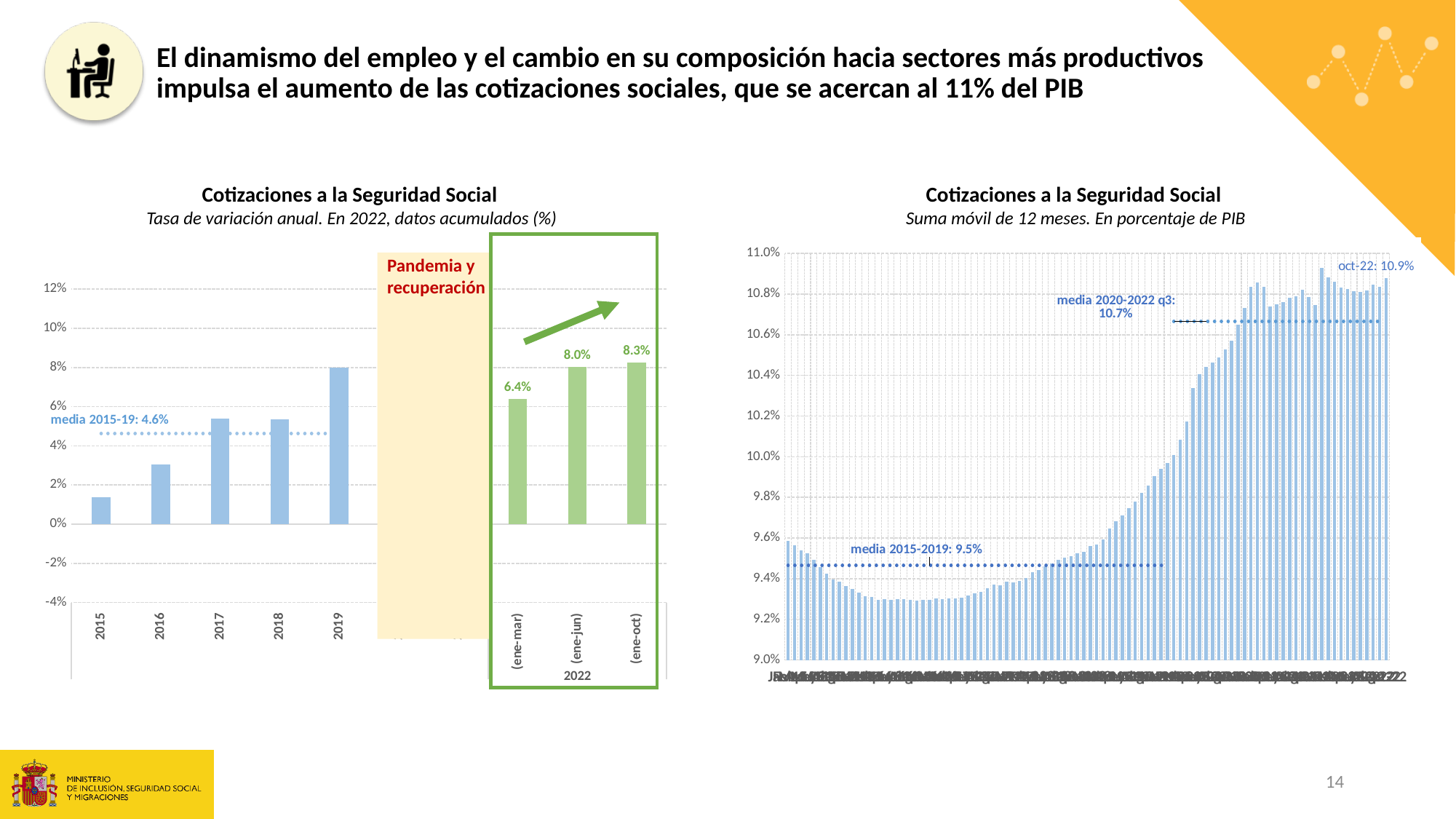
In the left chart (Tasa de variación anual), do the values rise or fall across the three 2022 periods? rise In the left chart (Tasa de variación anual), what is the difference between the 2022 (ene-oct) and 2022 (ene-mar) values? 1.9 percentage points In the left chart (Tasa de variación anual), what is the value for 2022 (ene-mar)? 6.4% In the left chart (Tasa de variación anual), what is the value of the 'media 2015-19' shown? 4.6% In the left chart (Tasa de variación anual), what is the value for 2022 (ene-oct)? 8.3% What kind of chart is the right chart (Suma móvil de 12 meses)? bar chart In the left chart (Tasa de variación anual), is the value for 2017 greater or less than 4%? greater In the left chart (Tasa de variación anual), how many blue bars are shown for the years 2015 to 2019? 5 In the right chart (Suma móvil de 12 meses), what is the value labelled for oct-22? 10.9% In the left chart (Tasa de variación anual), which of the three 2022 bars is the highest? ene-oct In the right chart (Suma móvil de 12 meses), what is the value of the 'media 2015-2019'? 9.5% In the left chart (Tasa de variación anual), is the value for 2015 greater or less than 2%? less